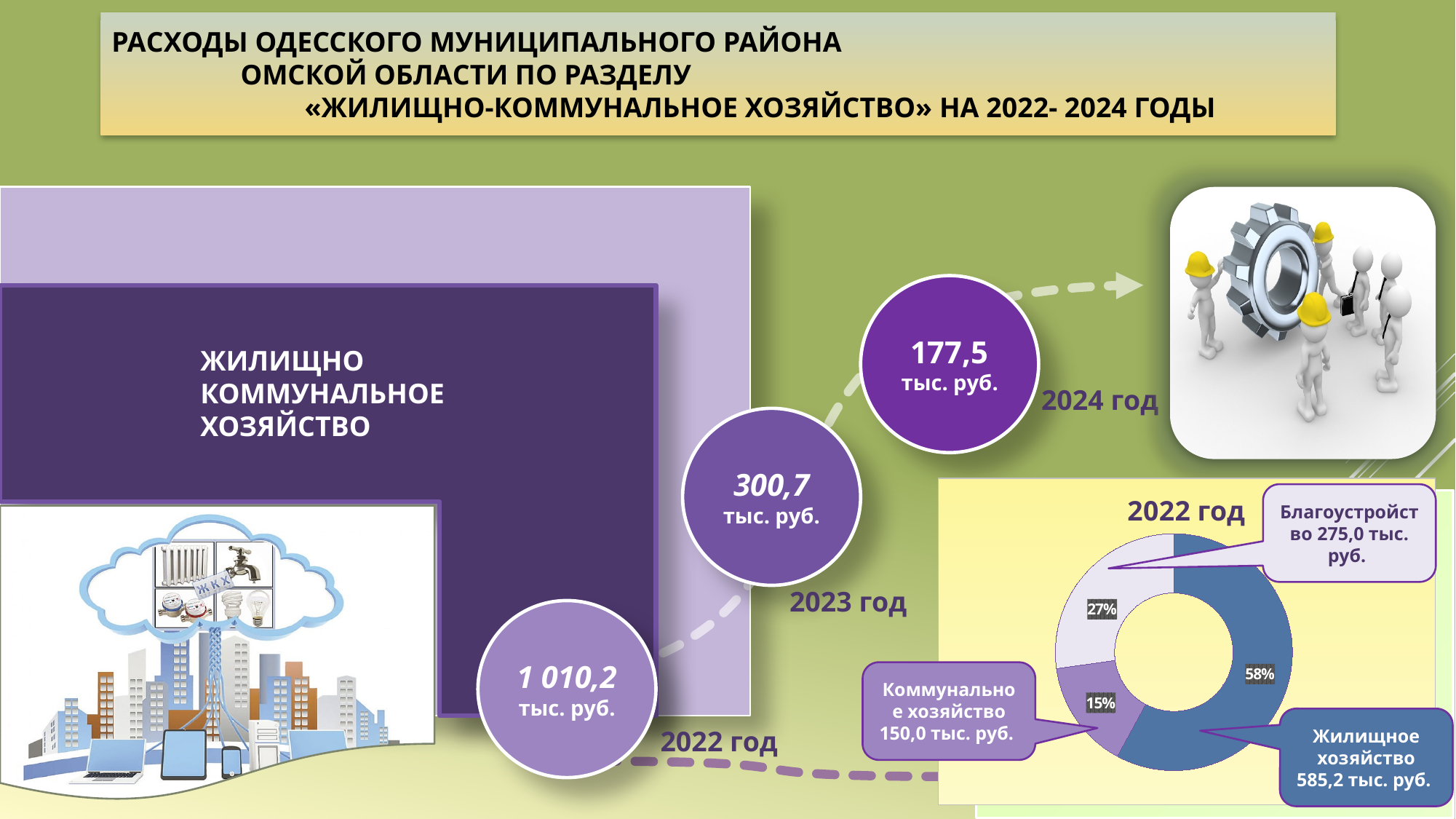
In the 2022 doughnut chart, what is the value for Жилищное хозяйство? 585,2 тыс. руб. In the 2022 doughnut chart, what is the value for Коммунальное хозяйство? 150,0 тыс. руб. In the 2022 doughnut chart, what is the value for Благоустройство? 275,0 тыс. руб. In the 2022 doughnut chart, what is the difference between Жилищное хозяйство and Благоустройство? 310,2 тыс. руб. How many slices does the doughnut chart for 2022 have? 3 In the 2022 doughnut chart, what share does Благоустройство have? 27% In the 2022 doughnut chart, what share does Жилищное хозяйство have? 58% In the 2022 doughnut chart, which category has the largest value? Жилищное хозяйство Which year does the doughnut chart at the bottom right refer to? 2022 год In the 2022 doughnut chart, which category has the smallest value? Коммунальное хозяйство In the 2022 doughnut chart, what share does Коммунальное хозяйство have? 15% What kind of chart is shown in the yellow panel at the bottom right of the slide? doughnut (pie) chart